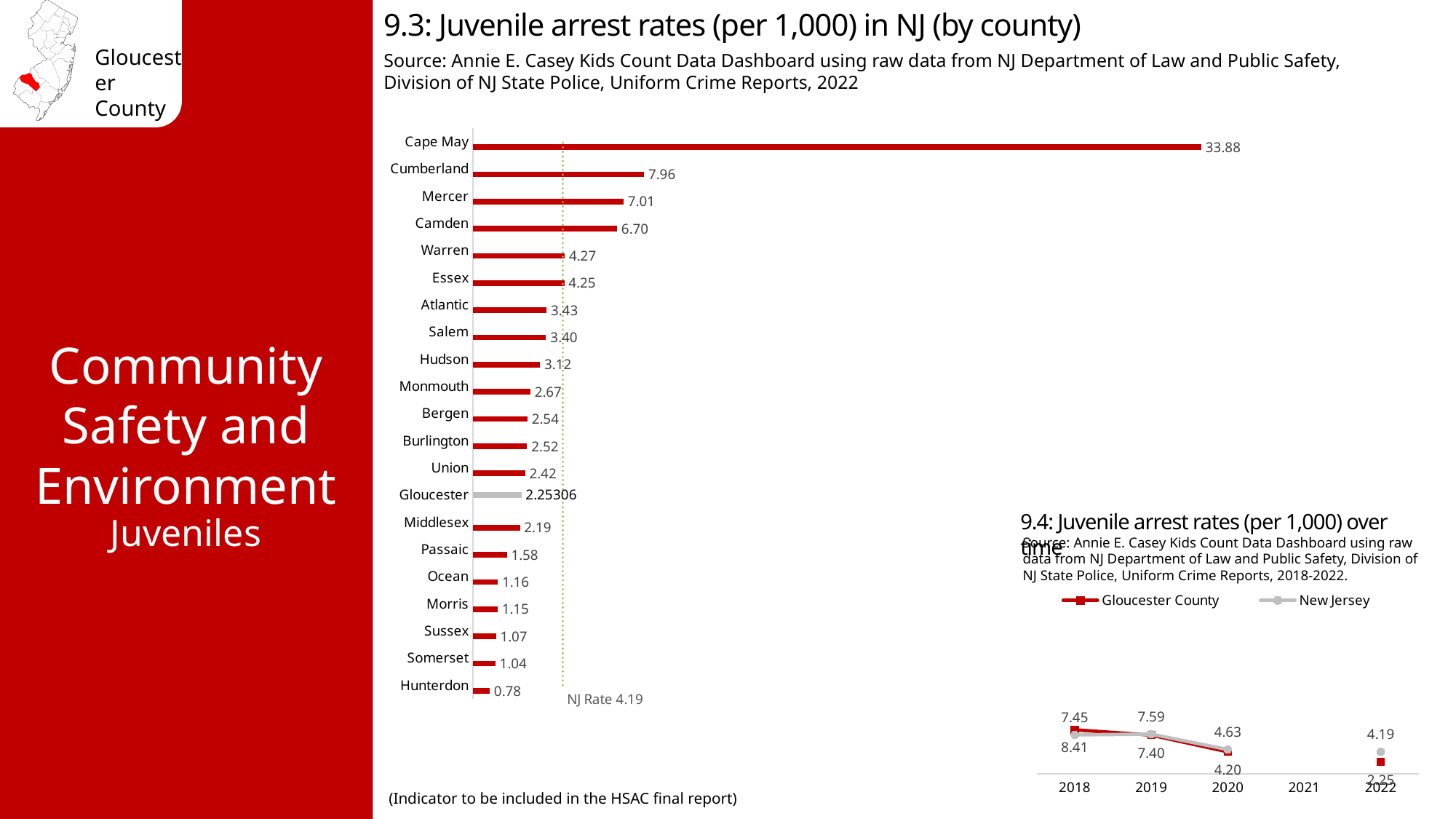
In the chart '9.3: Juvenile arrest rates (per 1,000) in NJ (by county)', which county has the lowest juvenile arrest rate? Hunterdon In the chart '9.3: Juvenile arrest rates (per 1,000) in NJ (by county)', which has a higher rate, Camden or Warren? Camden In the chart '9.3: Juvenile arrest rates (per 1,000) in NJ (by county)', what is the difference between the rates for Cumberland and Mercer? 0.95 In the chart '9.3: Juvenile arrest rates (per 1,000) in NJ (by county)', what is the value for Gloucester? 2.25306 In the chart '9.3: Juvenile arrest rates (per 1,000) in NJ (by county)', what is the juvenile arrest rate for Cape May? 33.88 What kind of chart is '9.3: Juvenile arrest rates (per 1,000) in NJ (by county)'? Bar chart In the chart '9.3: Juvenile arrest rates (per 1,000) in NJ (by county)', how many counties are shown? 21 In the chart '9.3: Juvenile arrest rates (per 1,000) in NJ (by county)', which county has the highest juvenile arrest rate? Cape May In the chart '9.4: Juvenile arrest rates (per 1,000) over time', do the Gloucester County values rise or fall from 2018 to 2022? Fall In the chart '9.4: Juvenile arrest rates (per 1,000) over time', which series is higher in 2022, Gloucester County or New Jersey? New Jersey In the chart '9.3: Juvenile arrest rates (per 1,000) in NJ (by county)', what NJ rate is marked by the dotted reference line? 4.19 In the chart '9.4: Juvenile arrest rates (per 1,000) over time', how many series does the legend list? 2